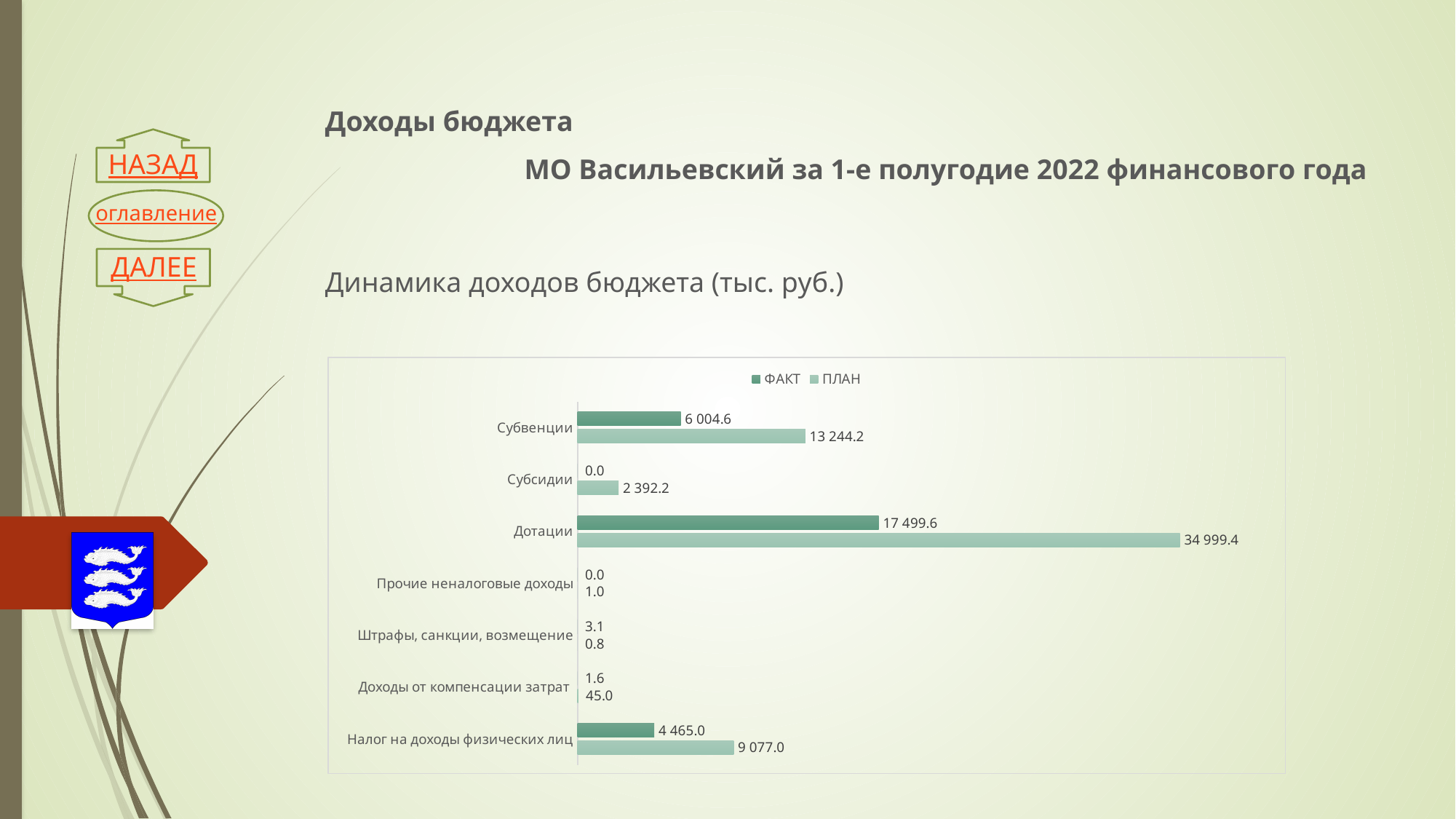
How many series does the chart legend list? 2 Which category has the lowest ПЛАН value? Штрафы, санкции, возмещение Which is larger for Налог на доходы физических лиц: the ФАКТ value or the ПЛАН value? ПЛАН What type of chart is shown on the slide? Bar chart What is the ПЛАН value for Субвенции? 13 244.2 What is the ФАКТ value for Штрафы, санкции, возмещение? 3.1 What is the ПЛАН value for Доходы от компенсации затрат? 45.0 What is the difference between the ПЛАН and ФАКТ values for Дотации? 17 499.8 What are the two series named in the chart legend? ФАКТ and ПЛАН How many categories are shown in the chart? 7 Which category has the highest ПЛАН value? Дотации What is the ФАКТ value for Дотации? 17 499.6